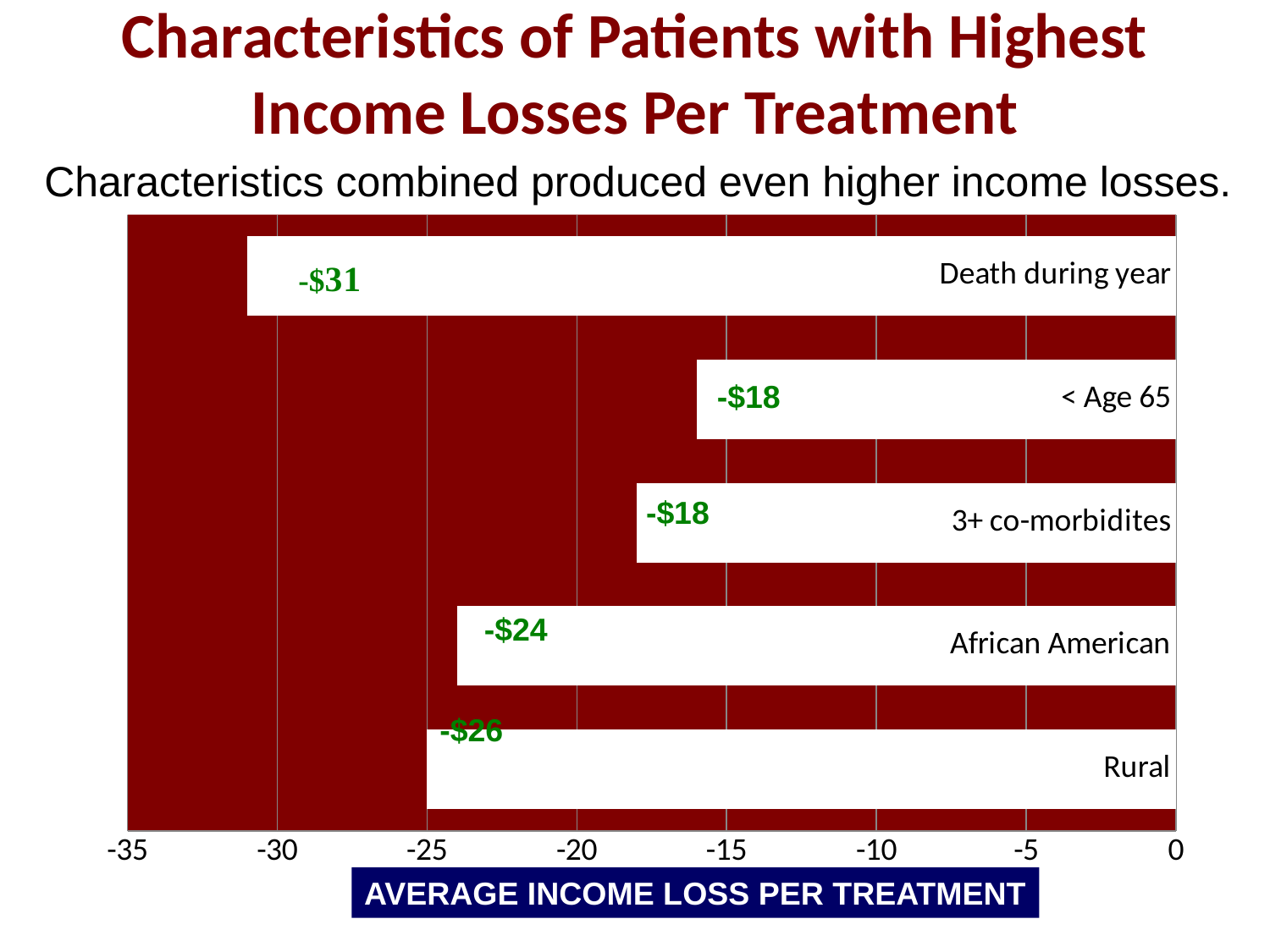
Which has a larger average income loss per treatment: death during year or rural? Death during year What is the label shown on the horizontal axis of the chart? AVERAGE INCOME LOSS PER TREATMENT What is the average income loss per treatment for African American patients? -$24 Which patient characteristic has the largest average income loss per treatment? Death during year What type of chart is shown on the slide? Bar chart What is the average income loss per treatment for patients with 3+ co-morbidities? -$18 How much larger is the income loss for death during year than for African American patients? $7 What is the difference between the income loss for rural patients and for African American patients? $2 What is the average income loss per treatment for patients with death during year? -$31 What is the average income loss per treatment for patients under age 65? -$18 How many patient characteristics are shown in the chart? 5 What is the average income loss per treatment for rural patients? -$26